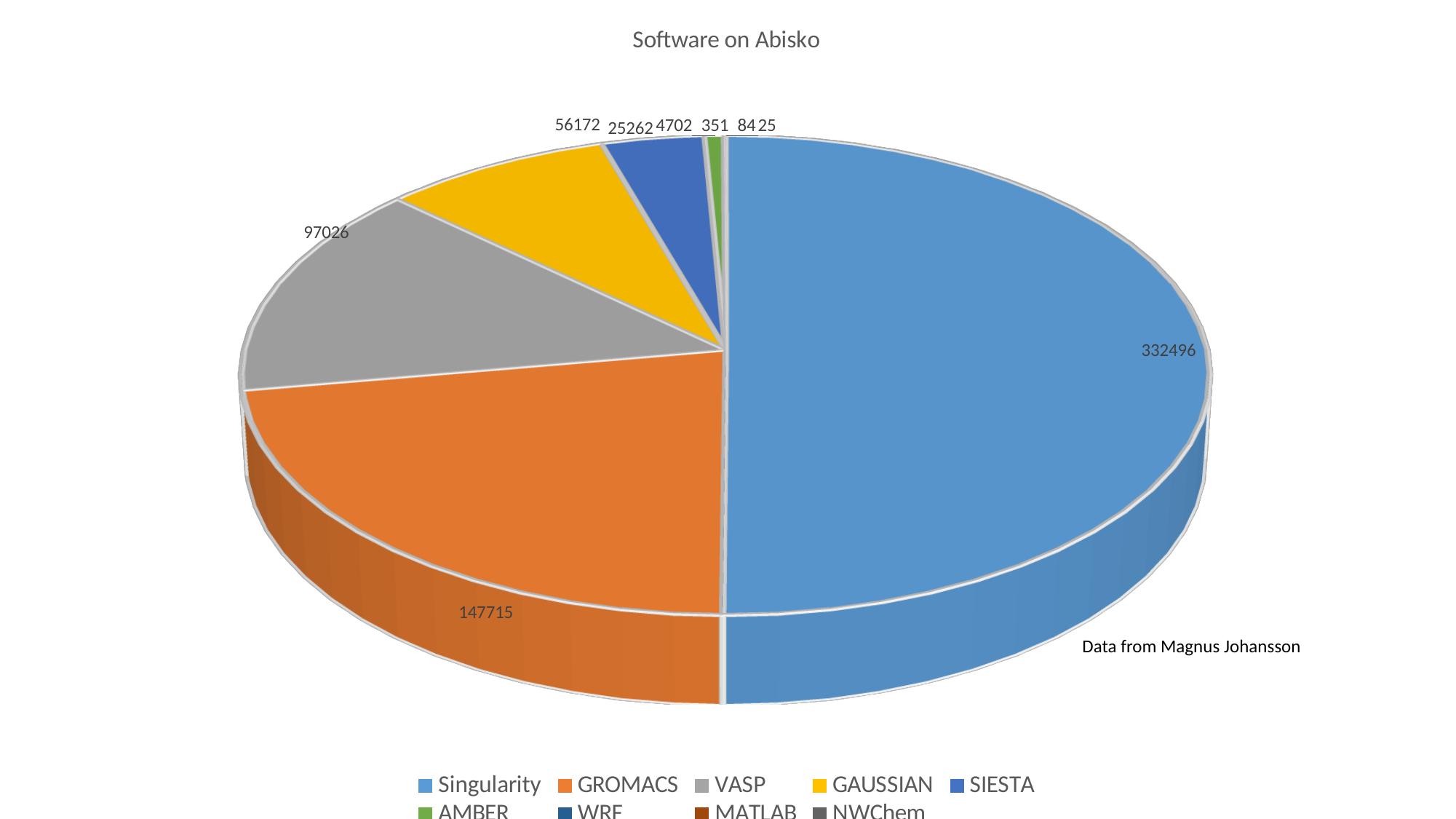
What type of chart is shown on the slide? Pie chart What is the title of the chart? Software on Abisko How many software entries does the legend list? 9 What is the value for Singularity? 332496 Which software has the largest slice of the pie? Singularity What is the value for GROMACS? 147715 What is the value for SIESTA? 25262 Which is larger, the value for GROMACS or the value for VASP? GROMACS What is the value for VASP? 97026 What is the difference between the values for Singularity and GROMACS? 184781 What is the difference between the values for VASP and GAUSSIAN? 40854 What is the value for GAUSSIAN? 56172